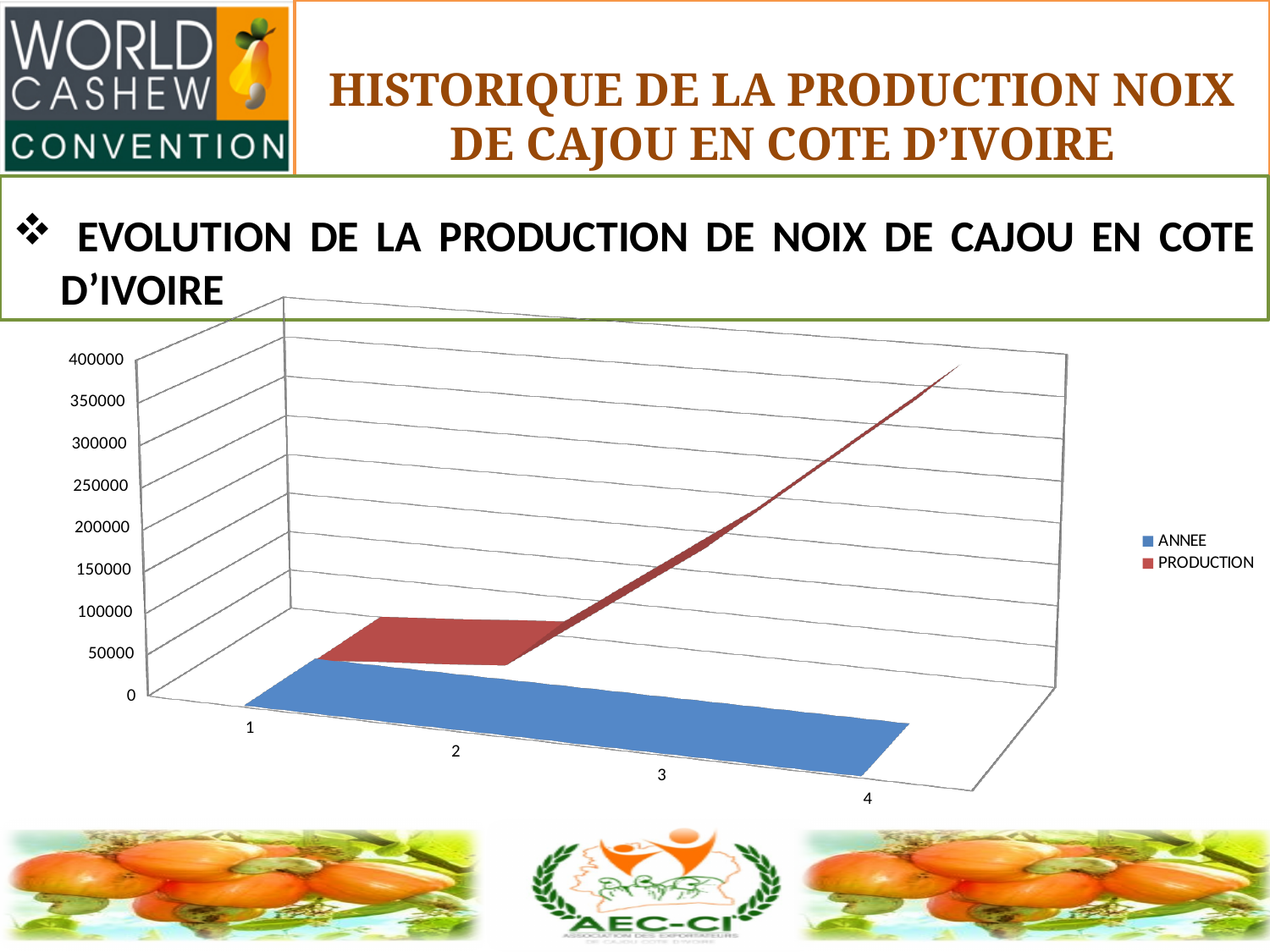
Is the PRODUCTION value at category 4 greater or less than 300000? greater Is the PRODUCTION value at category 1 greater or less than 100000? less Which is larger: the PRODUCTION value at category 4 or at category 1? Category 4 Which category has the highest PRODUCTION value? 4 What are the two series named in the chart legend? ANNEE and PRODUCTION How many categories are shown along the x axis of the chart? 4 Which series is larger at category 3, ANNEE or PRODUCTION? PRODUCTION Does the PRODUCTION series rise or fall from category 1 to category 4? Rise What kind of chart is shown on the slide? 3D line chart Is the ANNEE value at category 4 greater or less than 50000? less What is the highest value shown on the chart's vertical axis? 400000 How many series does the chart legend list? 2